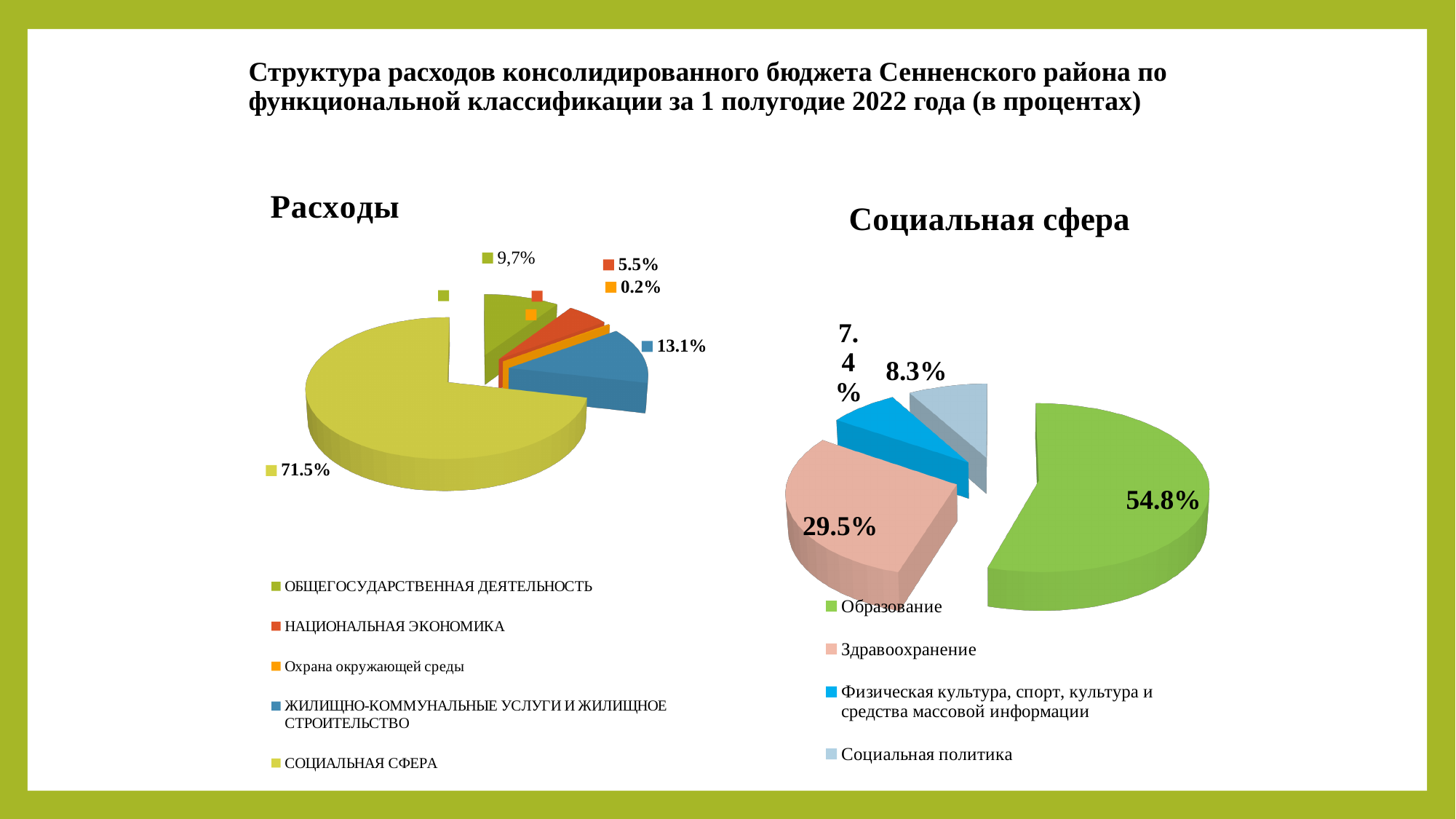
In the "Расходы" chart, which category has the smallest share? Охрана окружающей среды In the "Расходы" chart, what is the share for Охрана окружающей среды? 0.2% In the "Расходы" chart, which is larger: НАЦИОНАЛЬНАЯ ЭКОНОМИКА or ОБЩЕГОСУДАРСТВЕННАЯ ДЕЯТЕЛЬНОСТЬ? ОБЩЕГОСУДАРСТВЕННАЯ ДЕЯТЕЛЬНОСТЬ In the "Социальная сфера" chart, what is the share for Социальная политика? 8.3% In the "Социальная сфера" chart, what is the difference between the shares of Образование and Здравоохранение? 25.3% In the "Социальная сфера" chart, what is the share for Здравоохранение? 29.5% In the "Расходы" chart, what is the share for СОЦИАЛЬНАЯ СФЕРА? 71.5% What type of chart is the "Социальная сфера" chart? Pie chart In the "Социальная сфера" chart, how many categories does the legend list? 4 In the "Социальная сфера" chart, which category has the largest share? Образование In the "Расходы" chart, what is the share for ЖИЛИЩНО-КОММУНАЛЬНЫЕ УСЛУГИ И ЖИЛИЩНОЕ СТРОИТЕЛЬСТВО? 13.1% In the "Расходы" chart, how many categories does the legend list? 5